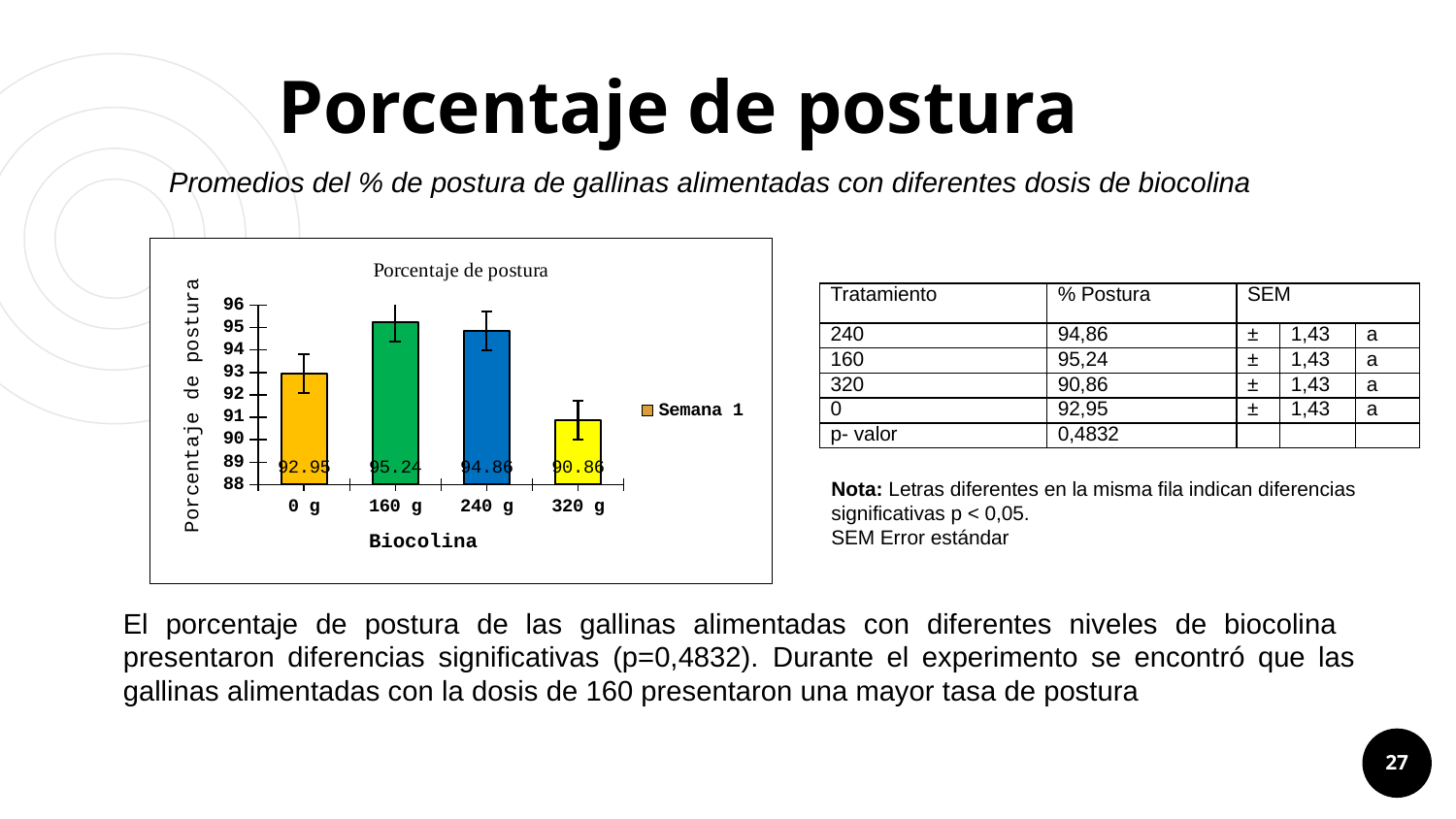
What is the value for 160 g in the chart? 95.24 What is the value for 320 g in the chart? 90.86 What is the difference between the values for 160 g and 320 g? 4.38 What is the value for 240 g in the chart? 94.86 What is the value for 0 g in the chart? 92.95 Which category has the highest value in the chart? 160 g Which category has the lowest value in the chart? 320 g What is the only series listed in the chart legend? Semana 1 Is the value for 320 g greater or less than 92? less What kind of chart is shown on the slide? bar chart Which is larger, the value for 0 g or the value for 240 g? 240 g How many categories are shown on the x axis of the chart? 4